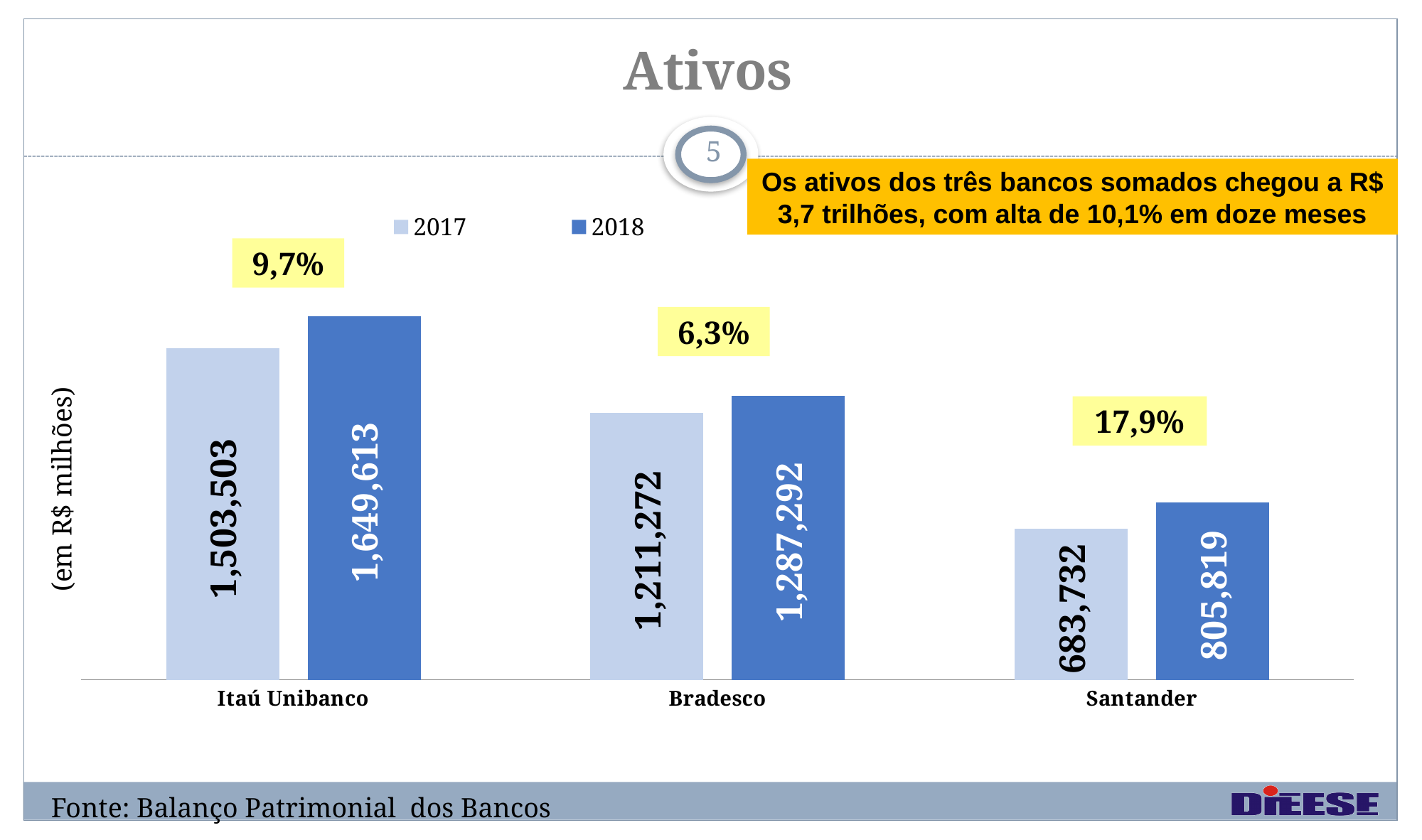
What percentage change is shown above the Santander bars? 17,9% What is the 2017 value for Bradesco? 1,211,272 Which bank has the lowest 2017 value? Santander How many banks are shown on the x axis? 3 What is the 2018 value for Itaú Unibanco? 1,649,613 Which is larger: the 2018 value for Bradesco or the 2017 value for Itaú Unibanco? 2017 value for Itaú Unibanco What kind of chart is shown on the slide? Bar chart What is the difference between the 2018 and 2017 values for Santander? 122,087 What is the 2017 value for Santander? 683,732 How many series does the legend list? 2 Which bank has the highest 2018 value? Itaú Unibanco What is the difference between the 2018 and 2017 values for Itaú Unibanco? 146,110